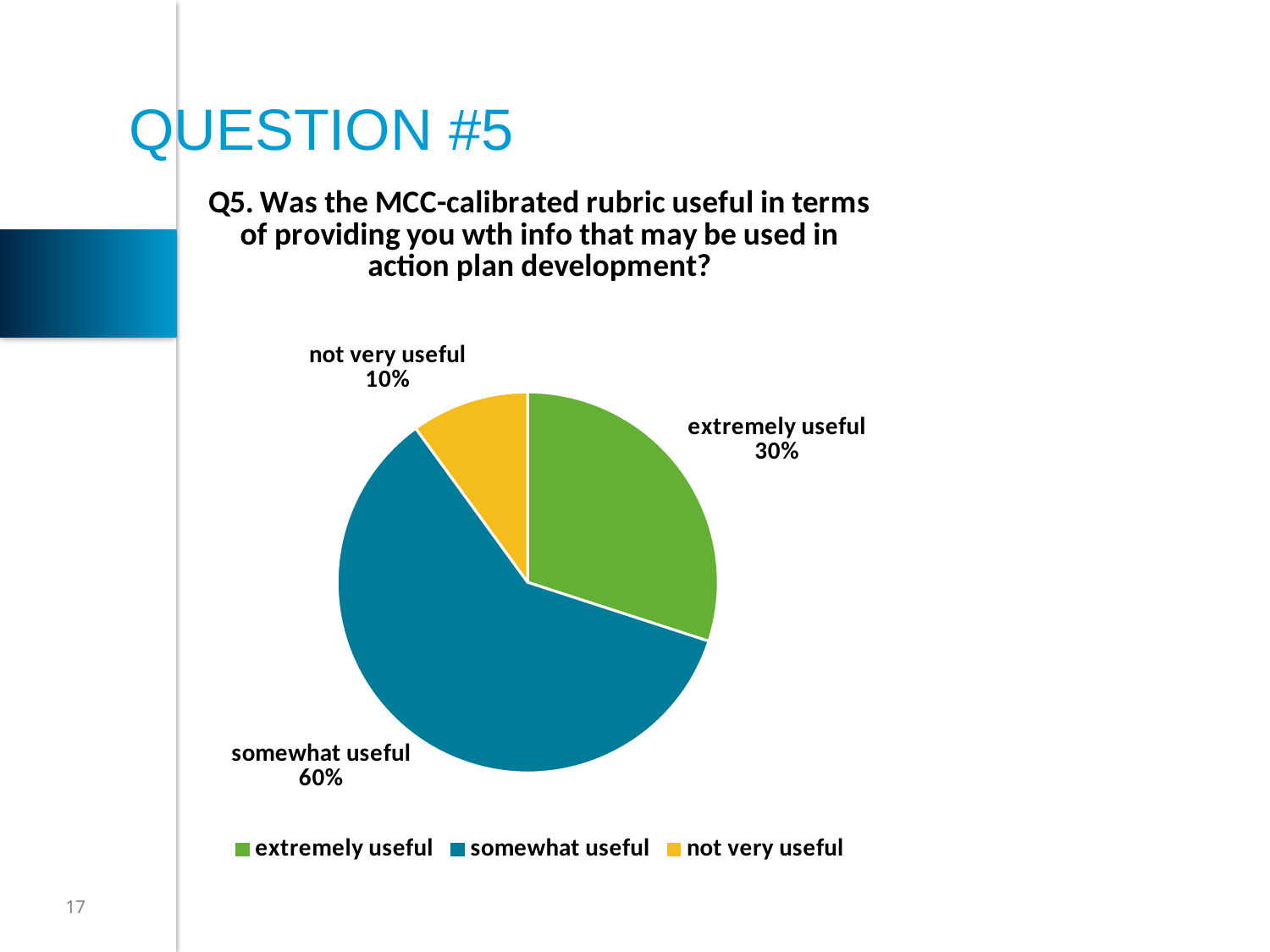
What kind of chart is shown on the slide? pie chart Which category has the smallest slice of the pie? not very useful What colour is the "not very useful" slice? yellow Which category has the largest slice of the pie? somewhat useful What colour is the "somewhat useful" slice? blue Which slice is larger, "extremely useful" or "not very useful"? extremely useful What share of the pie is labelled "somewhat useful"? 60% How many categories does the pie chart show? 3 What share of the pie is labelled "not very useful"? 10% What is the difference in percentage points between the "extremely useful" and "not very useful" slices? 20 What is the difference in percentage points between the "somewhat useful" and "extremely useful" slices? 30 What share of the pie is labelled "extremely useful"? 30%